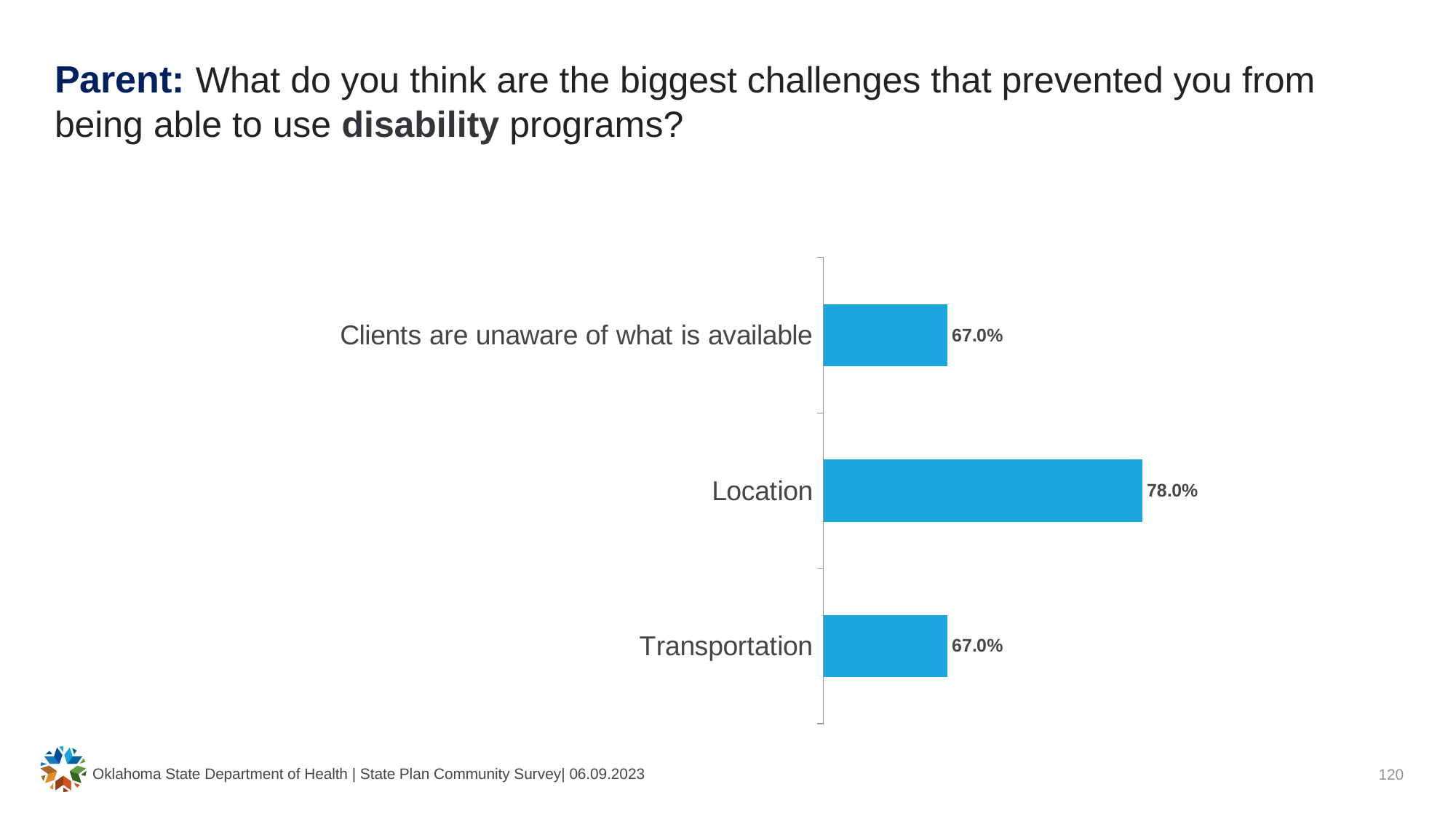
Which is larger, the value for Location or the value for 'Clients are unaware of what is available'? Location Which category has the highest value? Location What kind of chart is shown on the slide? Bar chart What is the difference between the values for Location and Transportation? 11.0% What colour are the bars in the chart? Blue What is the value for Location? 78.0% What is the value for Transportation? 67.0% How many categories are shown in the chart? 3 What is the value for 'Clients are unaware of what is available'? 67.0% Which two categories have the same value? Clients are unaware of what is available and Transportation